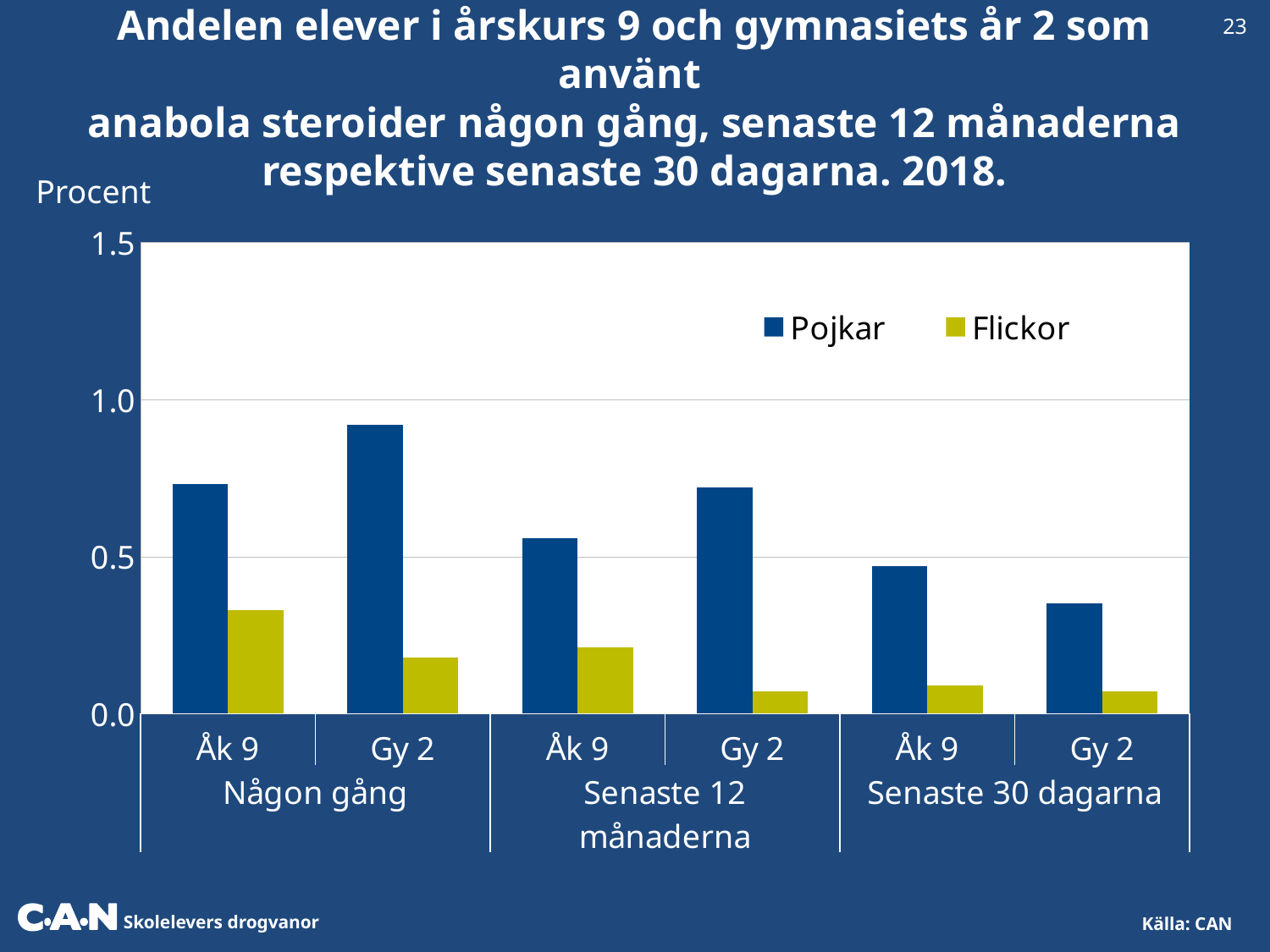
Is the value for Pojkar in Gy 2, Någon gång greater or less than 0.5? greater How many series does the legend list? 2 For Pojkar in Senaste 12 månaderna, which is larger, Åk 9 or Gy 2? Gy 2 Which category has the highest value for Flickor? Åk 9, Någon gång Is the value for Flickor in Åk 9, Någon gång greater or less than 0.5? less In Åk 9, Någon gång, which series has the larger value, Pojkar or Flickor? Pojkar Is the value for Pojkar in Gy 2, Någon gång greater or less than 1.0? less What kind of chart is shown on the slide? bar chart Which category has the highest value for Pojkar? Gy 2, Någon gång How many pairs of bars (categories) are plotted on the x axis? 6 What are the two series named in the legend? Pojkar and Flickor Which category has the lowest value for Pojkar? Gy 2, Senaste 30 dagarna